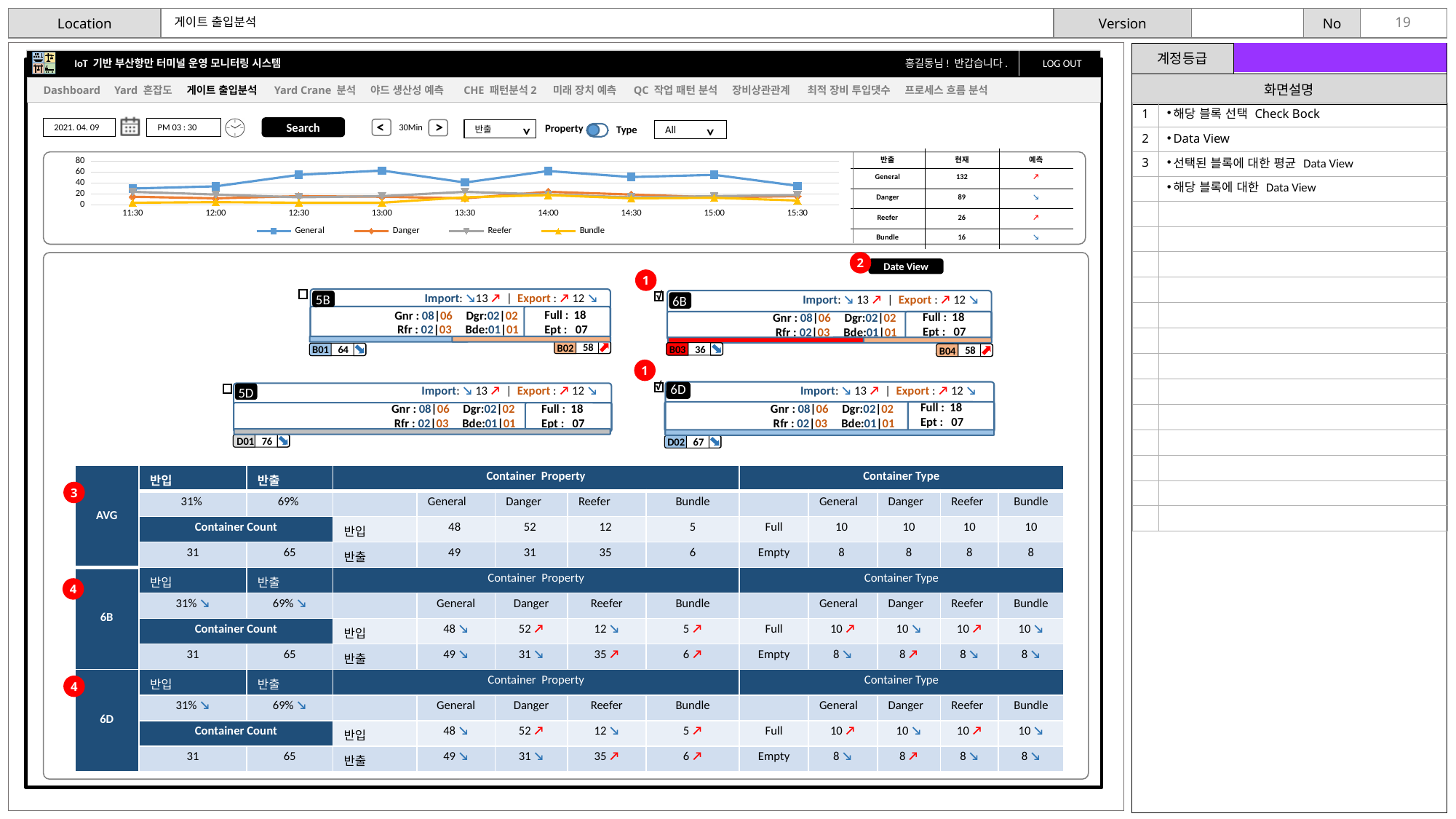
Does the General line rise or fall from 12:00 to 13:00? rise Is the value for General at 11:30 greater or less than 40? less How many series does the legend of the line chart list? 4 Which series has the highest value at 13:00 in the line chart? General What kind of chart is shown at the top of the slide? line chart What are the first and last time labels on the x axis of the line chart? 11:30 and 15:30 At 12:30, which is larger in the line chart: General or Bundle? General Is the value for General at 13:00 greater or less than 40? greater How many time points are shown along the x axis of the line chart? 9 Is the value for Danger at 14:00 greater or less than 40? less